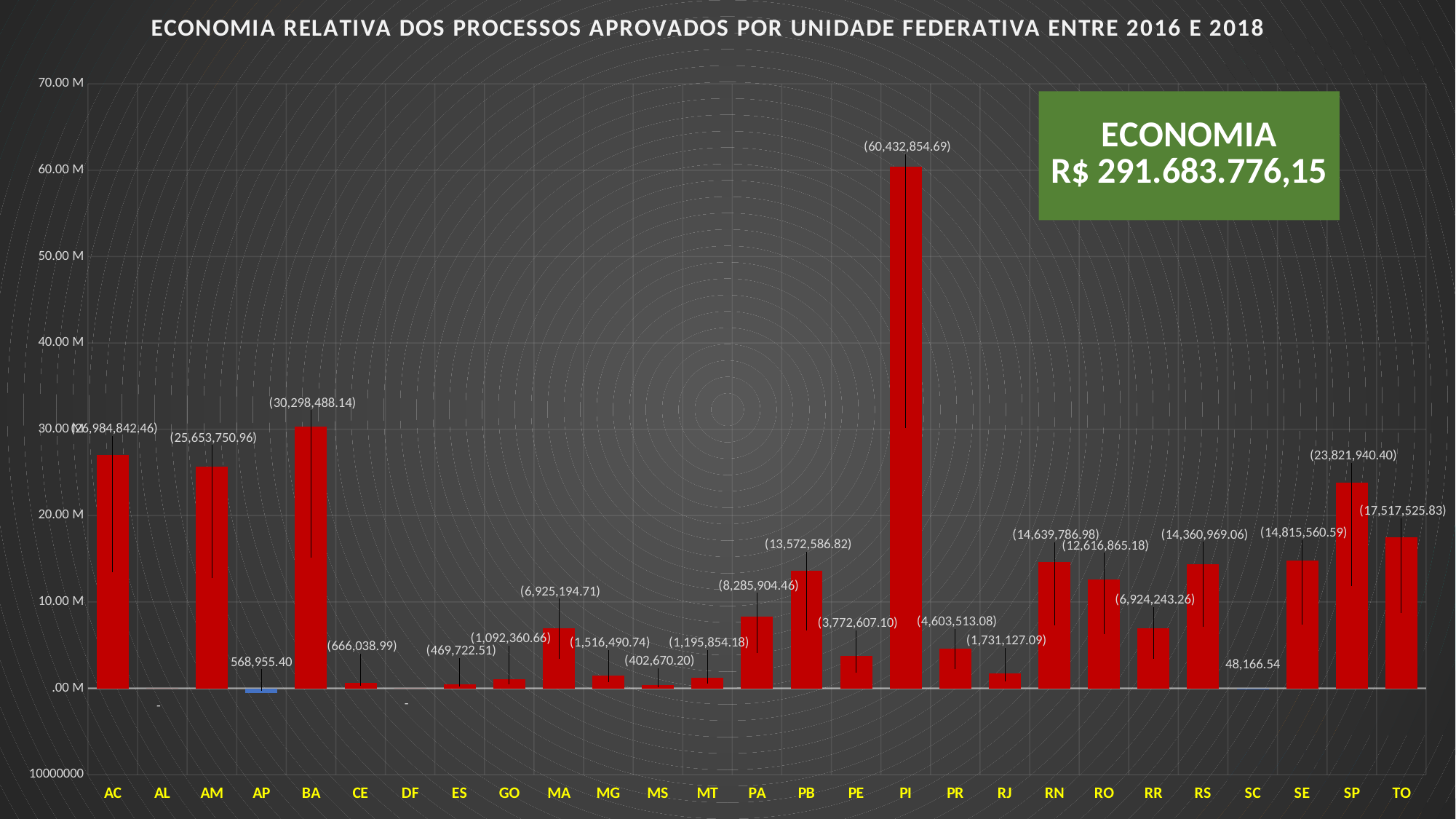
How many federative units (categories) are shown on the x axis? 27 What is the data label shown for BA? (30,298,488.14) What total economy value is shown in the green box on the slide? R$ 291.683.776,15 What is the data label shown for PI? (60,432,854.69) What is the data label shown for SP? (23,821,940.40) What is the data label shown for RN? (14,639,786.98) Which federative unit has the tallest bar? PI What type of chart is shown on the slide? bar chart Which bar is taller, AM or TO? AM What is the title of the chart? ECONOMIA RELATIVA DOS PROCESSOS APROVADOS POR UNIDADE FEDERATIVA ENTRE 2016 E 2018 What is the data label shown for SC? 48,166.54 Is the bar for PA greater or less than 10.00 M? less